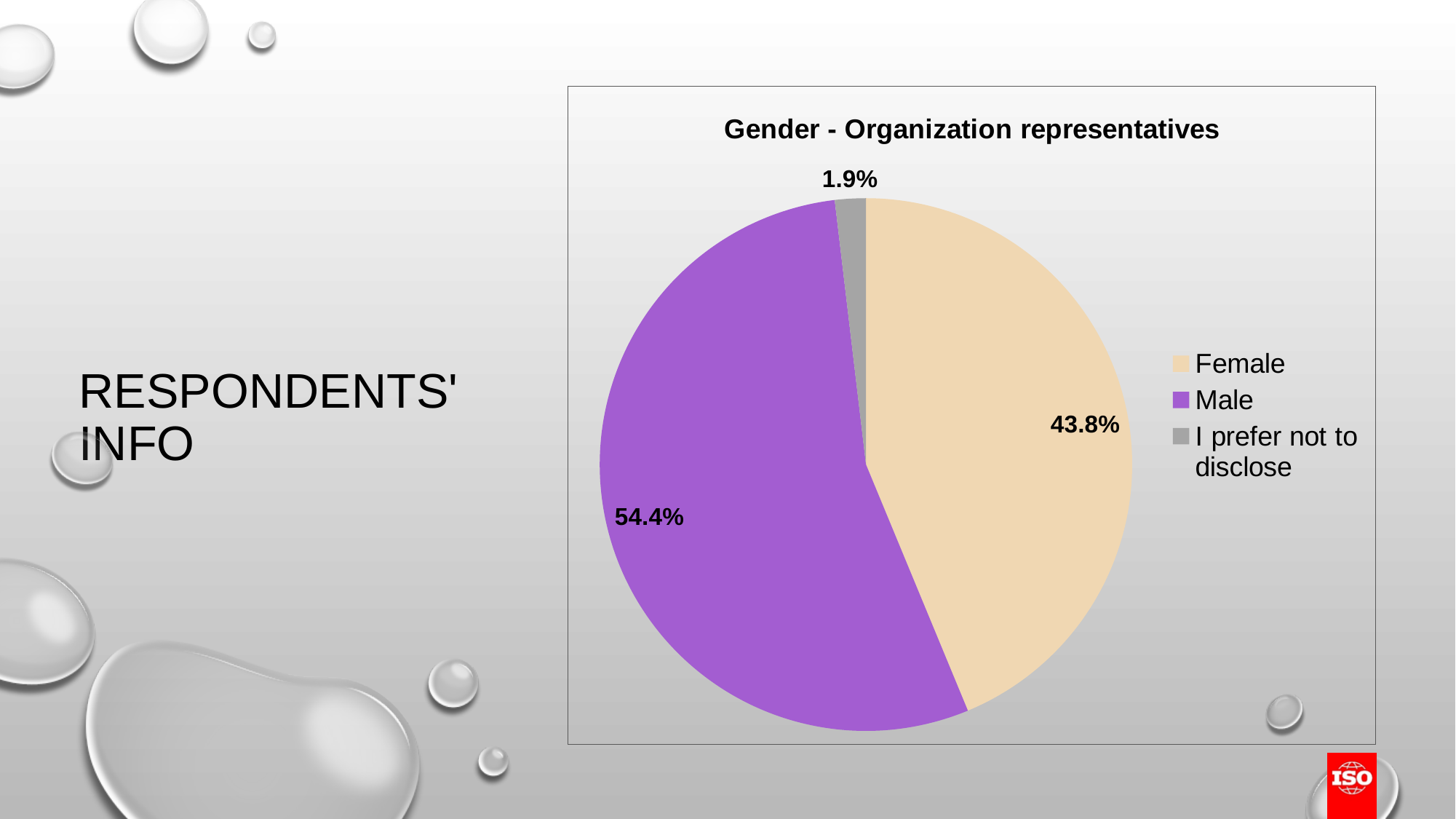
What is the difference in percentage points between the Female share and the 'I prefer not to disclose' share? 41.9 What percentage of organization representatives chose 'I prefer not to disclose'? 1.9% Which is larger, the Female share or the Male share? Male How many categories does the pie chart show? 3 Which category has the smallest share of the pie? I prefer not to disclose What is the title of the chart? Gender - Organization representatives What colour is the Male slice of the pie? purple What type of chart is shown on the slide? pie chart Which category has the largest share of the pie? Male What is the difference in percentage points between the Male and Female shares? 10.6 What percentage of organization representatives are Male? 54.4% What percentage of organization representatives are Female? 43.8%